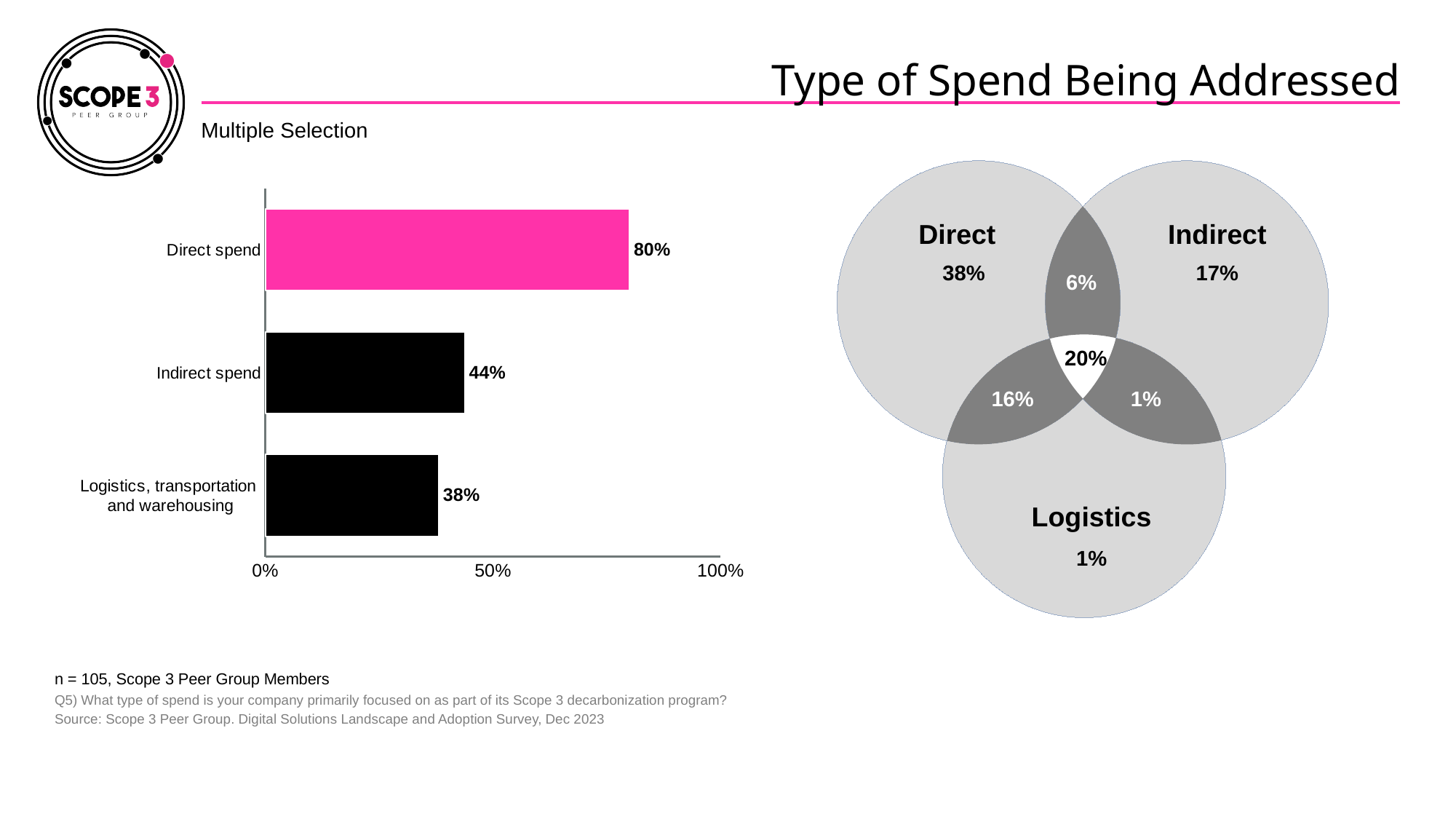
In the bar chart on the left, is the value for Direct spend greater or less than 50%? greater How many categories does the bar chart on the left show? 3 In the Venn diagram on the right, what percentage is shown in the overlap of all three circles? 20% In the Venn diagram on the right, what percentage is shown for Direct only? 38% In the bar chart on the left, which is larger: Indirect spend or Logistics, transportation and warehousing? Indirect spend In the bar chart on the left, which category has the highest value? Direct spend In the bar chart on the left, what is the difference between Direct spend and Indirect spend? 36% In the bar chart on the left, what is the value for Direct spend? 80% In the bar chart on the left, what is the value for Logistics, transportation and warehousing? 38% In the bar chart on the left, which category has the lowest value? Logistics, transportation and warehousing In the bar chart on the left, what is the value for Indirect spend? 44% What kind of chart is shown on the left of the slide? Bar chart